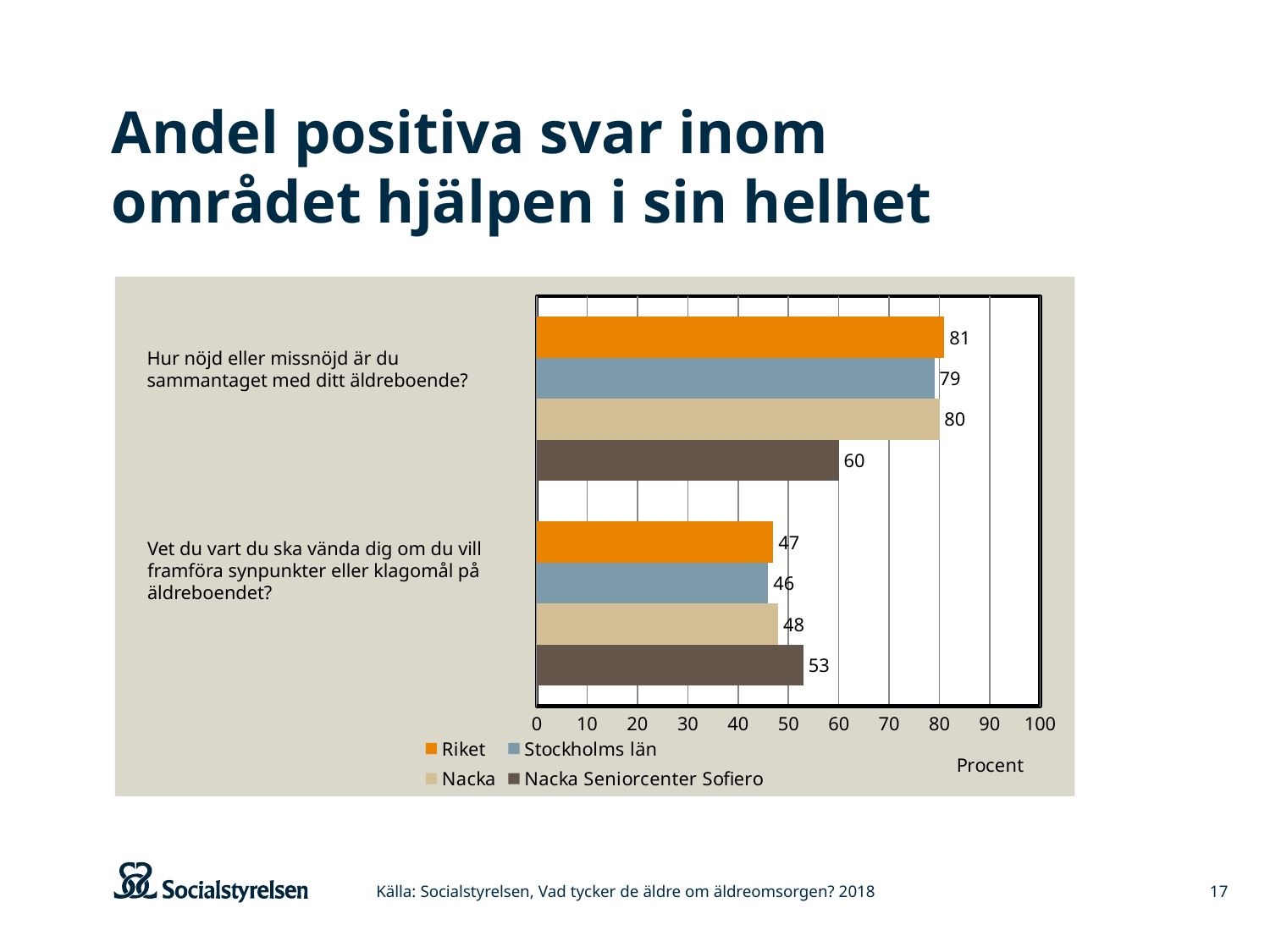
What is the label of the horizontal axis? Procent What is the value for Nacka Seniorcenter Sofiero on the question "Vet du vart du ska vända dig om du vill framföra synpunkter eller klagomål på äldreboendet?"? 53 What is the difference between Nacka Seniorcenter Sofiero and Riket on the question "Vet du vart du ska vända dig om du vill framföra synpunkter eller klagomål på äldreboendet?"? 6 What is the maximum value shown on the horizontal axis? 100 How many series does the legend list? 4 What is the difference between Nacka and Nacka Seniorcenter Sofiero on the question "Hur nöjd eller missnöjd är du sammantaget med ditt äldreboende?"? 20 Is the value for Nacka Seniorcenter Sofiero higher on the first question ("Hur nöjd eller missnöjd...") or the second question ("Vet du vart du ska vända dig...")? The first question Which series has the highest value on the question "Vet du vart du ska vända dig om du vill framföra synpunkter eller klagomål på äldreboendet?"? Nacka Seniorcenter Sofiero Which series has the lowest value on the question "Hur nöjd eller missnöjd är du sammantaget med ditt äldreboende?"? Nacka Seniorcenter Sofiero What is the value for Stockholms län on the question "Vet du vart du ska vända dig om du vill framföra synpunkter eller klagomål på äldreboendet?"? 46 What is the value for Riket on the question "Hur nöjd eller missnöjd är du sammantaget med ditt äldreboende?"? 81 What kind of chart is shown on the slide? Bar chart